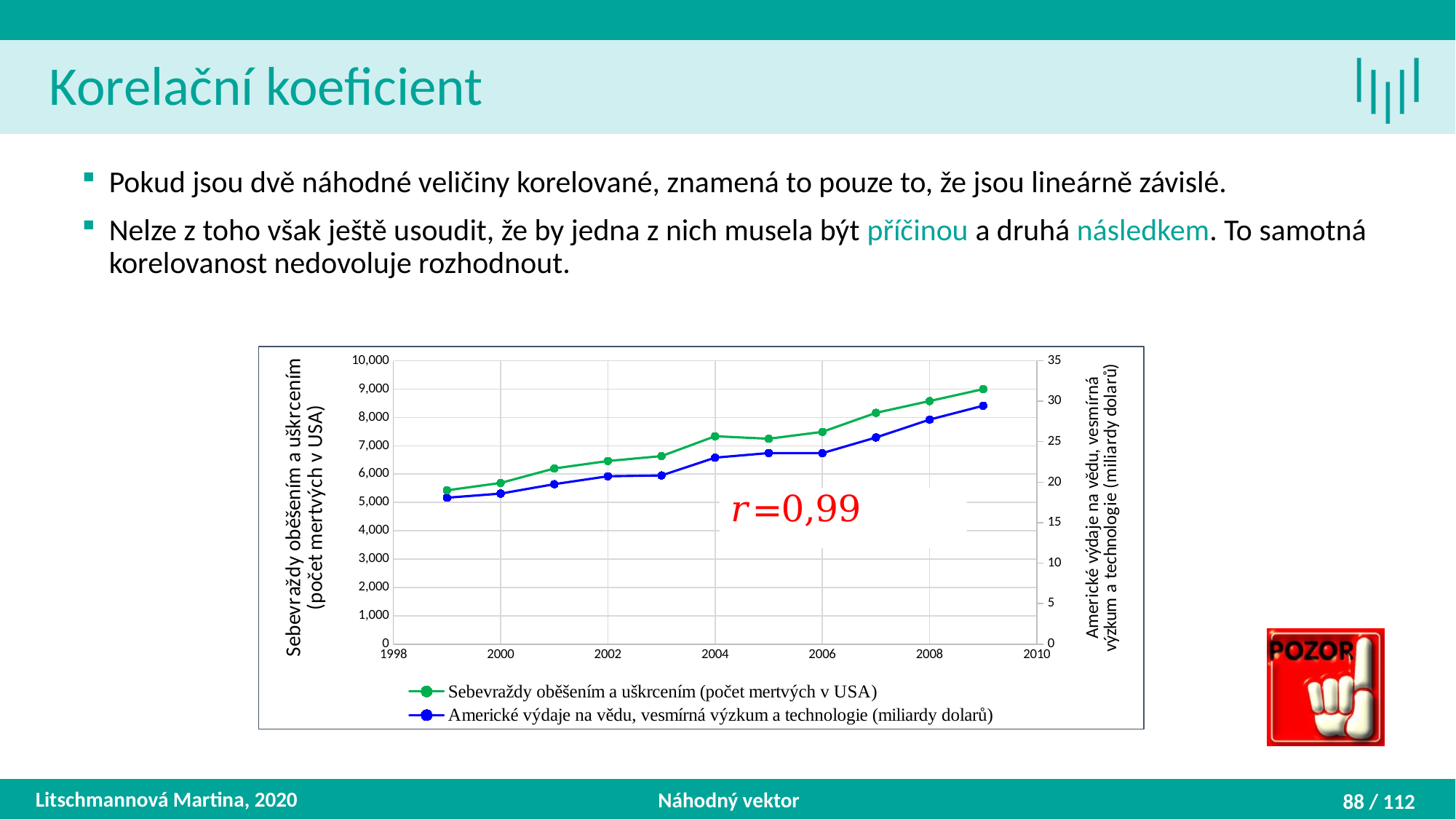
What correlation coefficient value is printed in red on the chart? r=0,99 Is the value for Sebevraždy oběšením a uškrcením in 1999 greater or less than 6,000? less What kind of chart is shown on the slide? line chart How many data points does the green series (Sebevraždy oběšením a uškrcením) have? 11 Is the value for Americké výdaje na vědu, vesmírná výzkum a technologie in 2009 greater or less than 25 (right axis)? greater Is the value for Sebevraždy oběšením a uškrcením in 2004 greater or less than 7,000? greater Which colour is used for the series Americké výdaje na vědu, vesmírná výzkum a technologie (miliardy dolarů)? blue Do the values of the series Sebevraždy oběšením a uškrcením generally rise or fall from 1999 to 2009? rise In which year is the value of Americké výdaje na vědu, vesmírná výzkum a technologie lowest? 1999 How many series does the chart legend list? 2 In which year is the value of Sebevraždy oběšením a uškrcením (počet mertvých v USA) highest? 2009